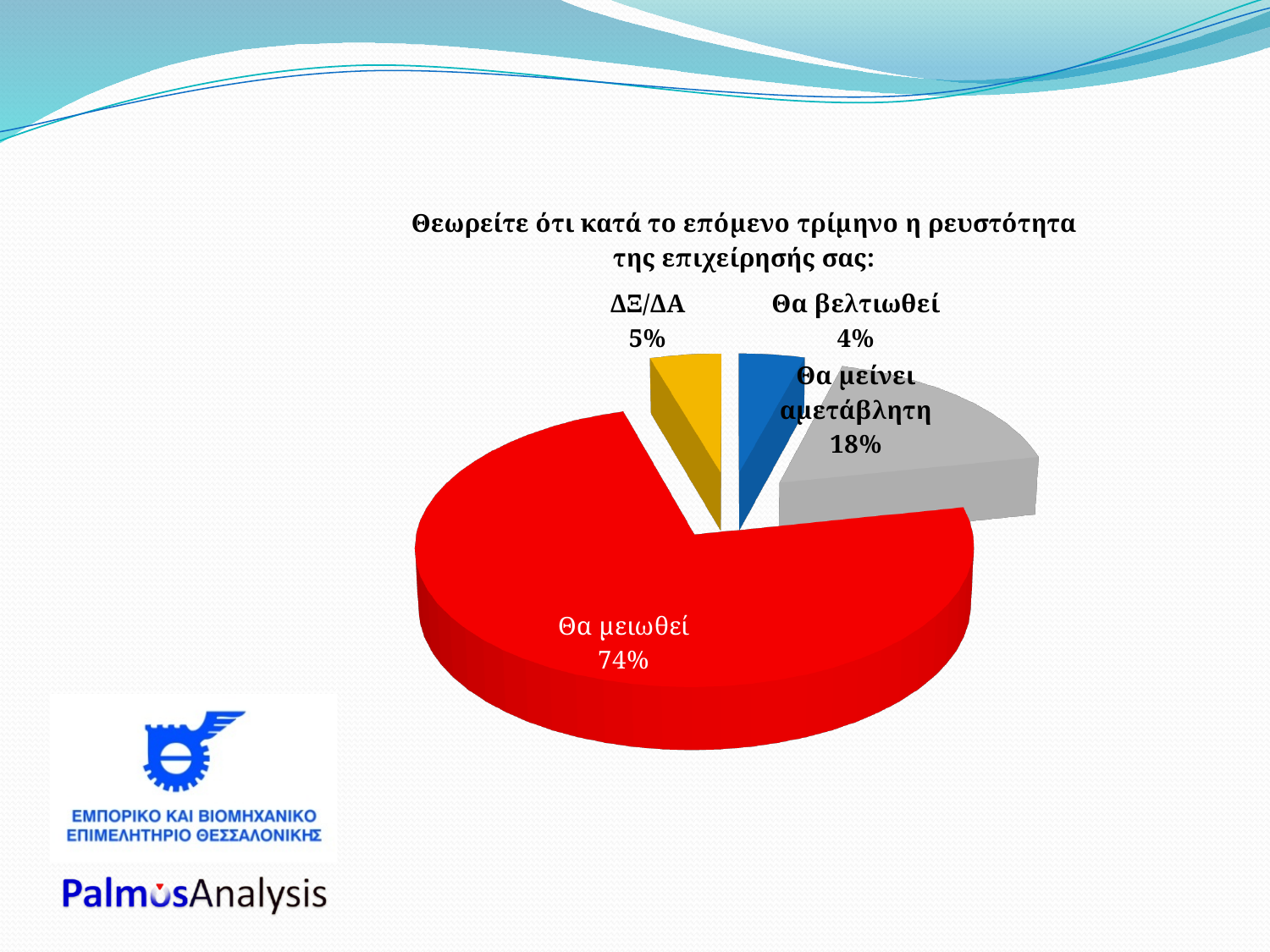
What share of the pie does "Θα βελτιωθεί" represent? 4% What share of the pie does "Θα μειωθεί" represent? 74% What is the difference in percentage points between "Θα μειωθεί" and "Θα μείνει αμετάβλητη"? 56 What share of the pie does "Θα μείνει αμετάβλητη" represent? 18% How many slices does the pie chart have? 4 What kind of chart is shown on the slide? pie chart Which category has the largest slice of the pie? Θα μειωθεί Which category has the smallest slice of the pie? Θα βελτιωθεί What colour is the slice for "Θα μειωθεί"? red Which is larger, the share for "ΔΞ/ΔΑ" or the share for "Θα βελτιωθεί"? ΔΞ/ΔΑ What is the title of the chart? Θεωρείτε ότι κατά το επόμενο τρίμηνο η ρευστότητα της επιχείρησής σας: